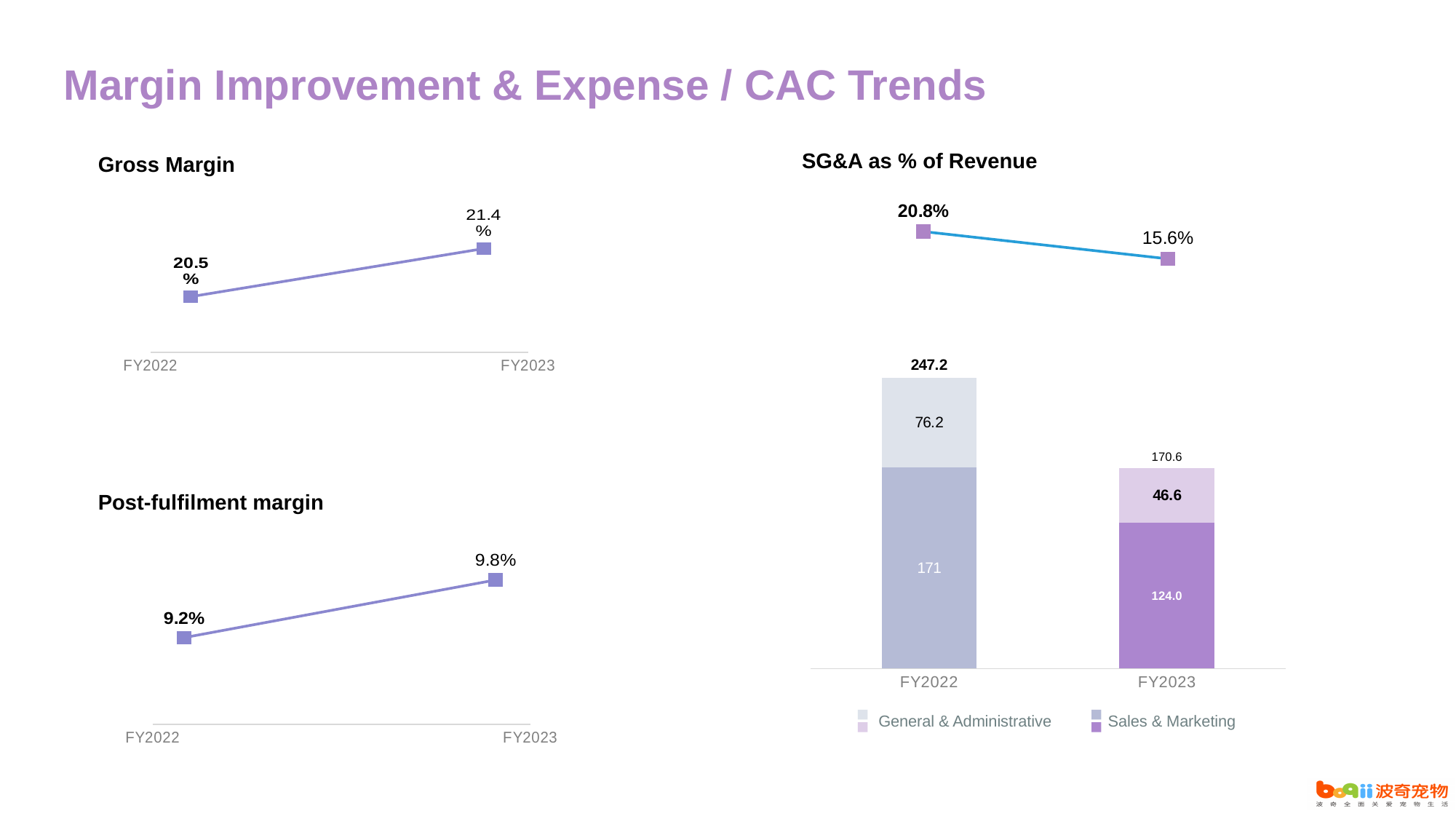
In the Post-fulfilment margin chart, what is the value for FY2022? 9.2% In the SG&A as % of Revenue line chart, do values rise or fall from FY2022 to FY2023? fall In the Post-fulfilment margin chart, what is the value for FY2023? 9.8% In the Gross Margin chart, what is the value for FY2022? 20.5% In the Gross Margin chart, what is the value for FY2023? 21.4% In the SG&A stacked bar chart, how many series does the legend list? 2 In the SG&A stacked bar chart, what is the total of the FY2022 bar? 247.2 In the SG&A stacked bar chart, what is the General & Administrative value for FY2022? 76.2 What kind of chart is the Post-fulfilment margin chart? line chart In the SG&A stacked bar chart, what is the Sales & Marketing value for FY2023? 124.0 In the Gross Margin chart, do values rise or fall from FY2022 to FY2023? rise In the SG&A as % of Revenue line chart, what is the value for FY2023? 15.6%